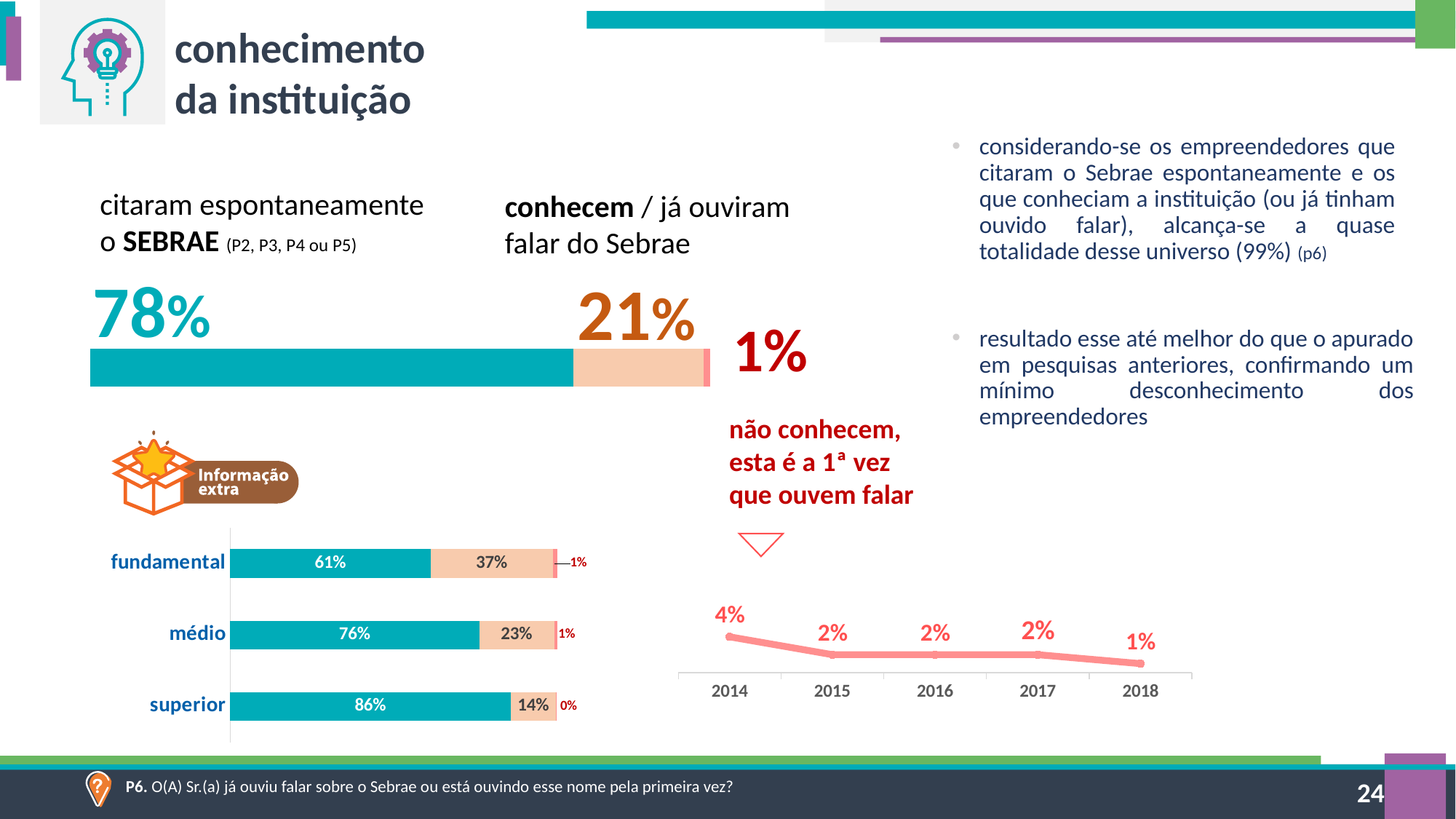
In the top stacked bar, what percentage of entrepreneurs cited Sebrae spontaneously? 78% What type of chart is shown at the bottom right of the slide (2014–2018)? line chart In the bottom-left bar chart by education level, what is the difference between the teal values for 'superior' and 'médio'? 10% In the bottom-left bar chart by education level, which category has the lowest teal (spontaneous citation) value? fundamental In the bottom-right line chart, do the values rise or fall from 2014 to 2018? fall In the bottom-left bar chart by education level, what is the value of the second (peach) segment for 'fundamental'? 37% How many education categories are shown in the bottom-left bar chart? 3 In the bottom-right line chart, what is the value for 2014? 4% In the bottom-left bar chart by education level, which category has the highest teal (spontaneous citation) value? superior In the bottom-left bar chart by education level, what is the value of the first (teal) segment for 'superior'? 86% In the top stacked bar, what percentage know / have already heard of Sebrae? 21% In the top stacked bar, what percentage do not know Sebrae and are hearing the name for the first time? 1%